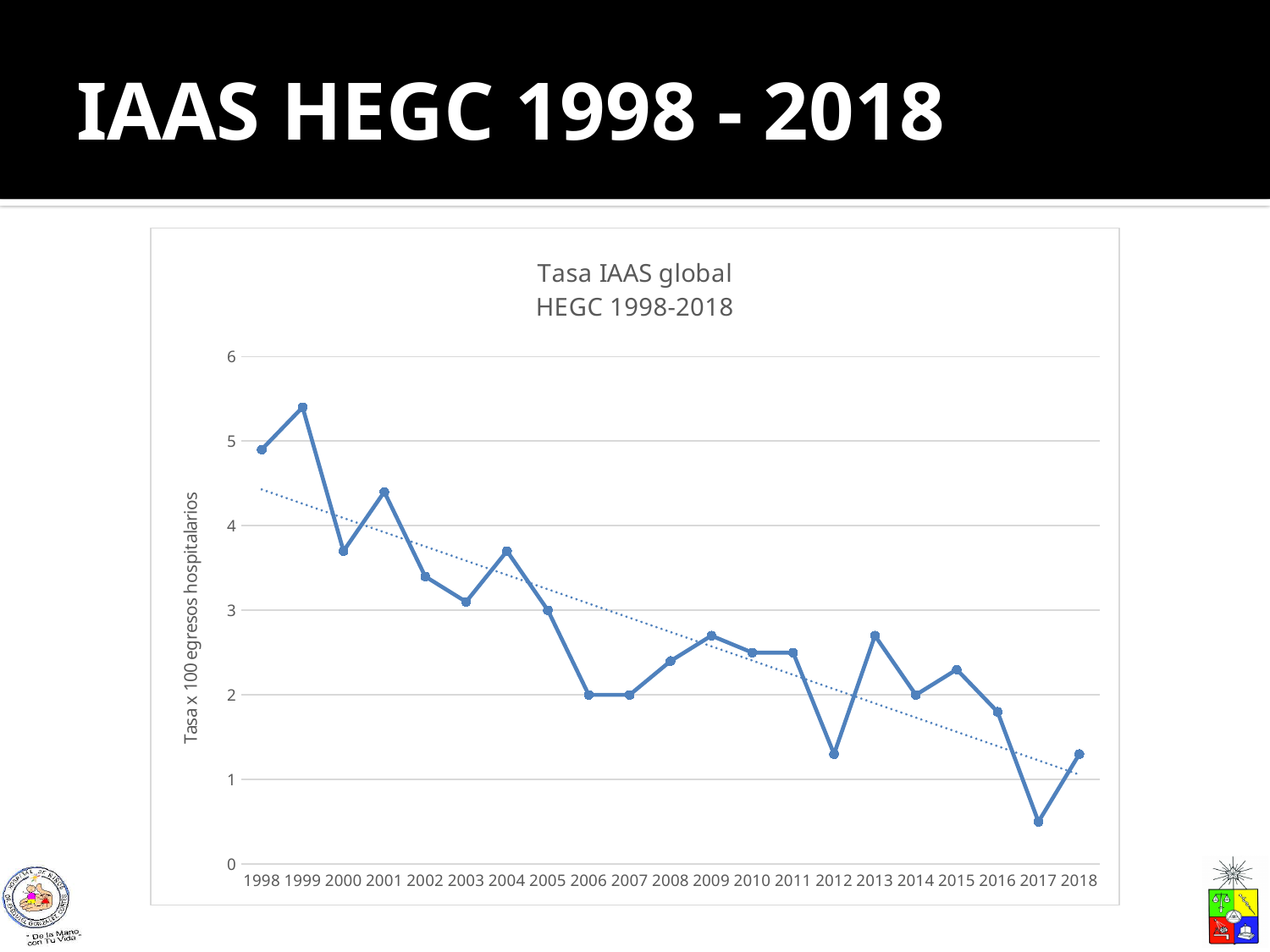
Which year has the lowest rate in the chart? 2017 Is the value for 2012 greater or less than 2? less What is the title of the chart? Tasa IAAS global HEGC 1998-2018 Overall, do the values rise or fall from 1998 to 2018? fall Which year has the larger value, 2000 or 2001? 2001 Is the value for 1998 greater or less than 4? greater Is the value for 2017 greater or less than 1? less What is the label on the vertical axis of the chart? Tasa x 100 egresos hospitalarios What kind of chart is shown on the slide? line chart Which year has the highest rate in the chart? 1999 How many years are plotted along the x axis of the chart? 21